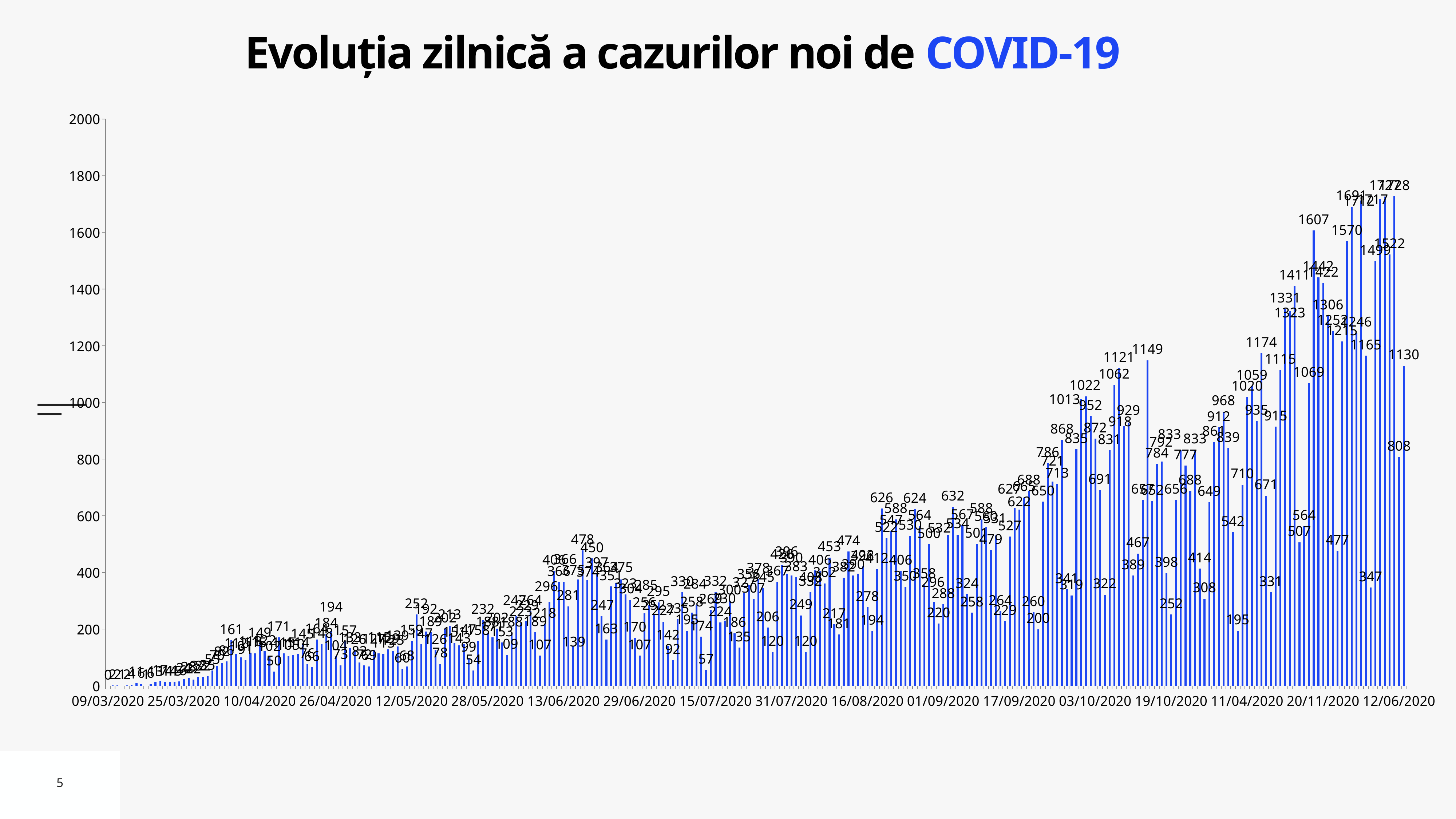
What is the difference between the bars labeled 1607 and 1570? 37 What is the value of the last (rightmost) bar on the chart? 1130 Is the tallest bar on the chart greater or less than 1600? greater How many data series are plotted on the chart? 1 What kind of chart is shown on the slide? bar chart What is the highest value shown on the y axis? 2000 Which is larger, the bar labeled 808 or the bar labeled 1130 near the right end of the chart? 1130 Is the tallest bar on the chart greater or less than 2000? less Is the value of the first bar, at 09/03/2020, greater or less than 200? less Overall, do the daily values rise or fall from left to right along the x axis? rise What is the title of the chart? Evoluția zilnică a cazurilor noi de COVID-19